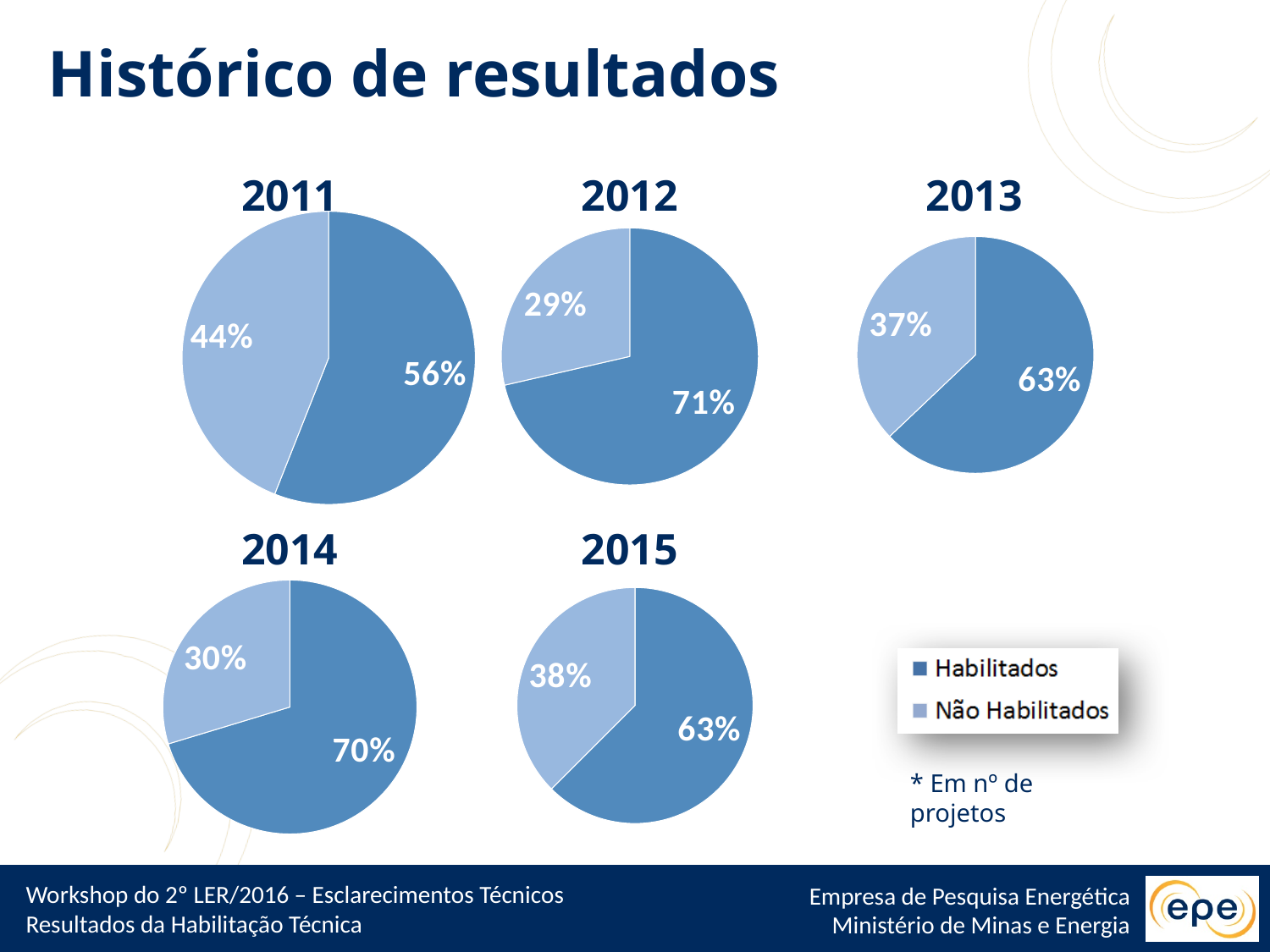
How many entries does the legend list? 2 What kind of chart is used for each year on the slide? Pie chart Across the five pie charts, which year has the lowest share of Habilitados? 2011 How many pie charts are shown on the slide? 5 In the 2015 pie chart, what share is Habilitados? 63% Which is larger: the Não Habilitados share in 2013 or in 2015? 2015 In the 2013 pie chart, what share is Habilitados? 63% Across the five pie charts, which year has the highest share of Habilitados? 2012 In the 2014 pie chart, what share is Não Habilitados? 30% In the 2012 pie chart, what share is Não Habilitados? 29% In the 2011 pie chart, what share is Habilitados? 56% In the 2011 pie chart, what is the difference between the Habilitados and Não Habilitados shares? 12%